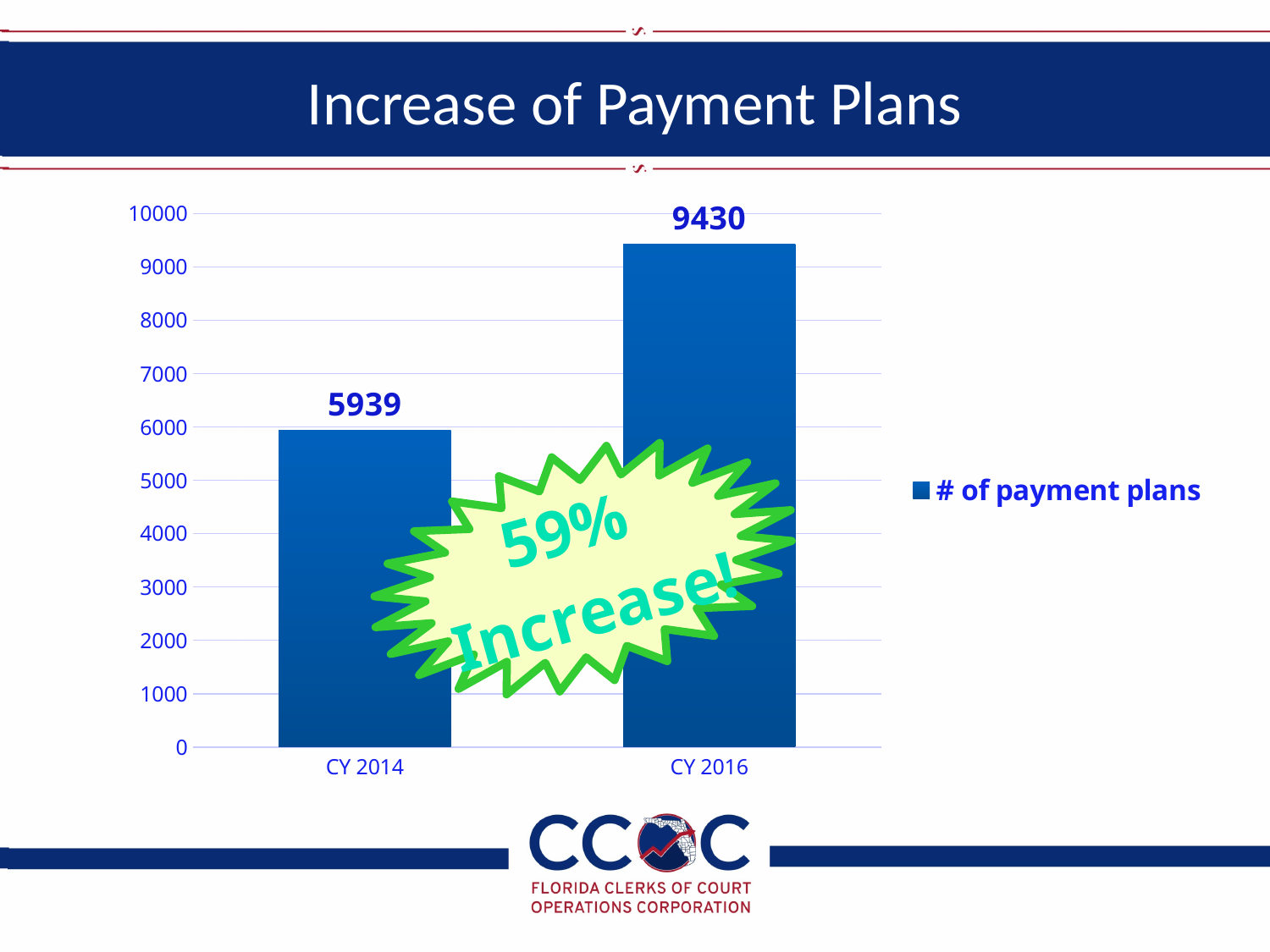
How many series does the legend list? 1 Which year has the higher number of payment plans? CY 2016 Which year has the lower number of payment plans? CY 2014 What is the number of payment plans for CY 2016? 9430 What is the legend entry for the series shown? # of payment plans Is the value for CY 2014 greater or less than 5000? greater What kind of chart is shown on the slide? bar chart Is the number of payment plans larger in CY 2014 or CY 2016? CY 2016 How many categories are shown on the x axis? 2 Is the value for CY 2016 greater or less than 10000? less What is the difference in the number of payment plans between CY 2016 and CY 2014? 3491 What is the number of payment plans for CY 2014? 5939